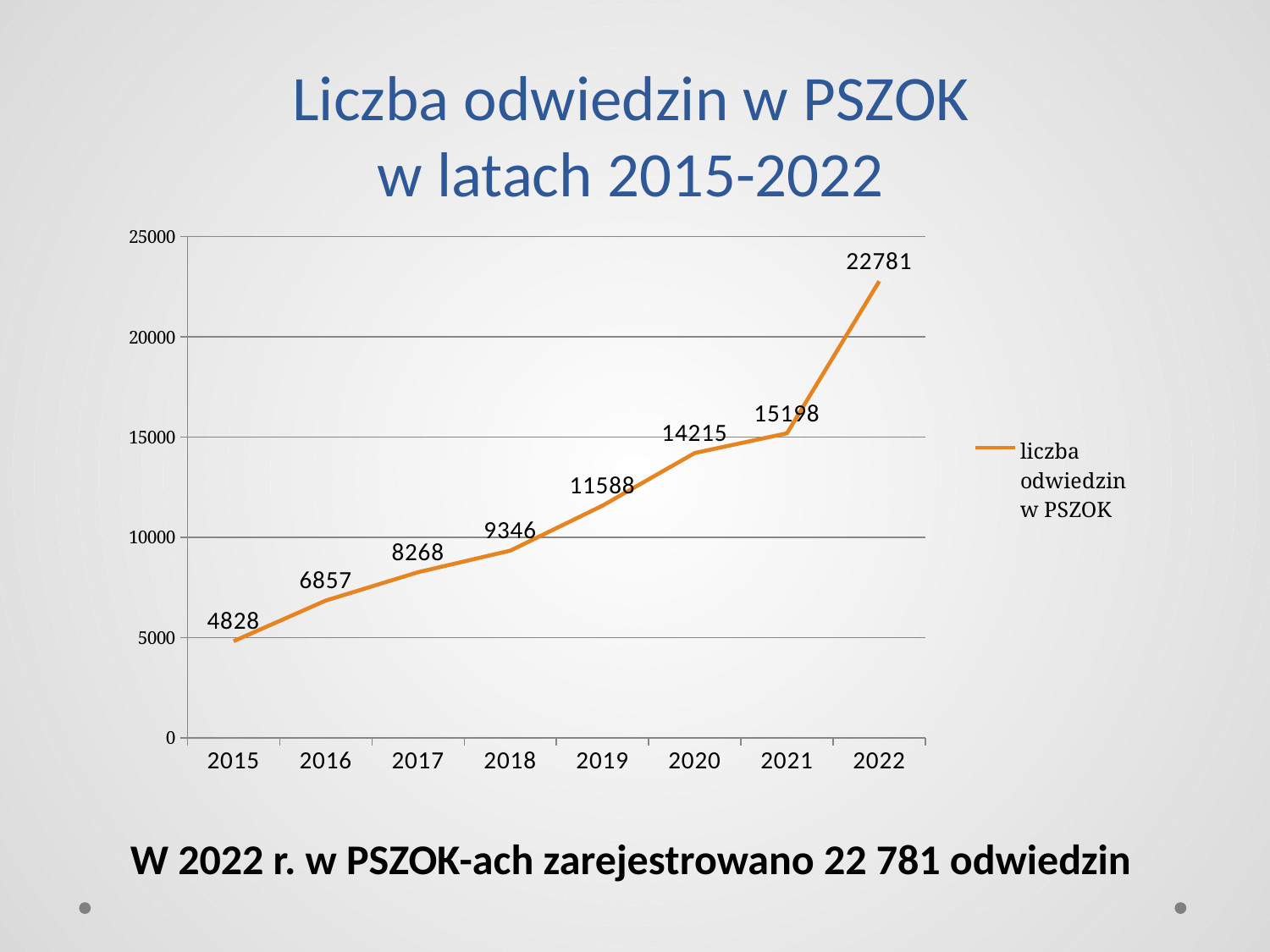
What value is shown for 2019? 11588 What was the number of visits to PSZOK in 2015? 4828 Is the value for 2020 greater or less than 15000? less What is the difference between the values for 2016 and 2015? 2029 What kind of chart is shown on the slide? line chart Do the values rise or fall from 2015 to 2022? rise How many years are plotted on the x axis? 8 Which year has the lowest number of visits? 2015 Which is larger, the value for 2018 or the value for 2017? 2018 Which year has the highest number of visits? 2022 What is the difference between the values for 2022 and 2021? 7583 What was the number of visits in 2021? 15198